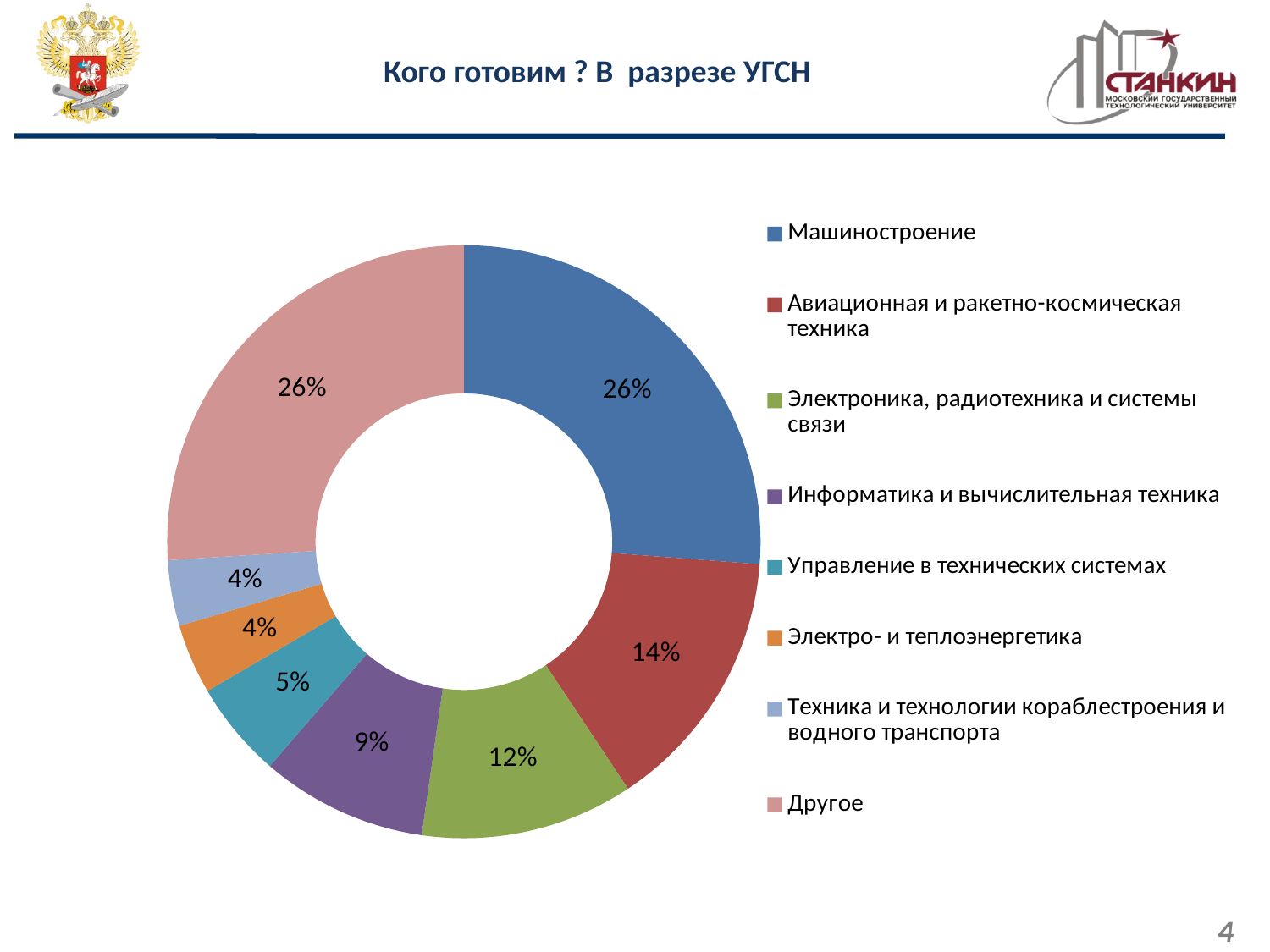
What is the value for Авиационная и ракетно-космическая техника? 14% What share of the pie does Машиностроение have? 26% What is the difference between the values for Авиационная и ракетно-космическая техника and Электроника, радиотехника и системы связи? 2% What is the value for Управление в технических системах? 5% What is the value for Информатика и вычислительная техника? 9% What share of the pie does Другое have? 26% What kind of chart is shown on the slide? doughnut chart What is the value for Электроника, радиотехника и системы связи? 12% How many categories does the legend list? 8 Which is larger: Информатика и вычислительная техника or Управление в технических системах? Информатика и вычислительная техника What is the title of the slide containing the chart? Кого готовим ? В разрезе УГСН What is the difference between the values for Машиностроение and Информатика и вычислительная техника? 17%